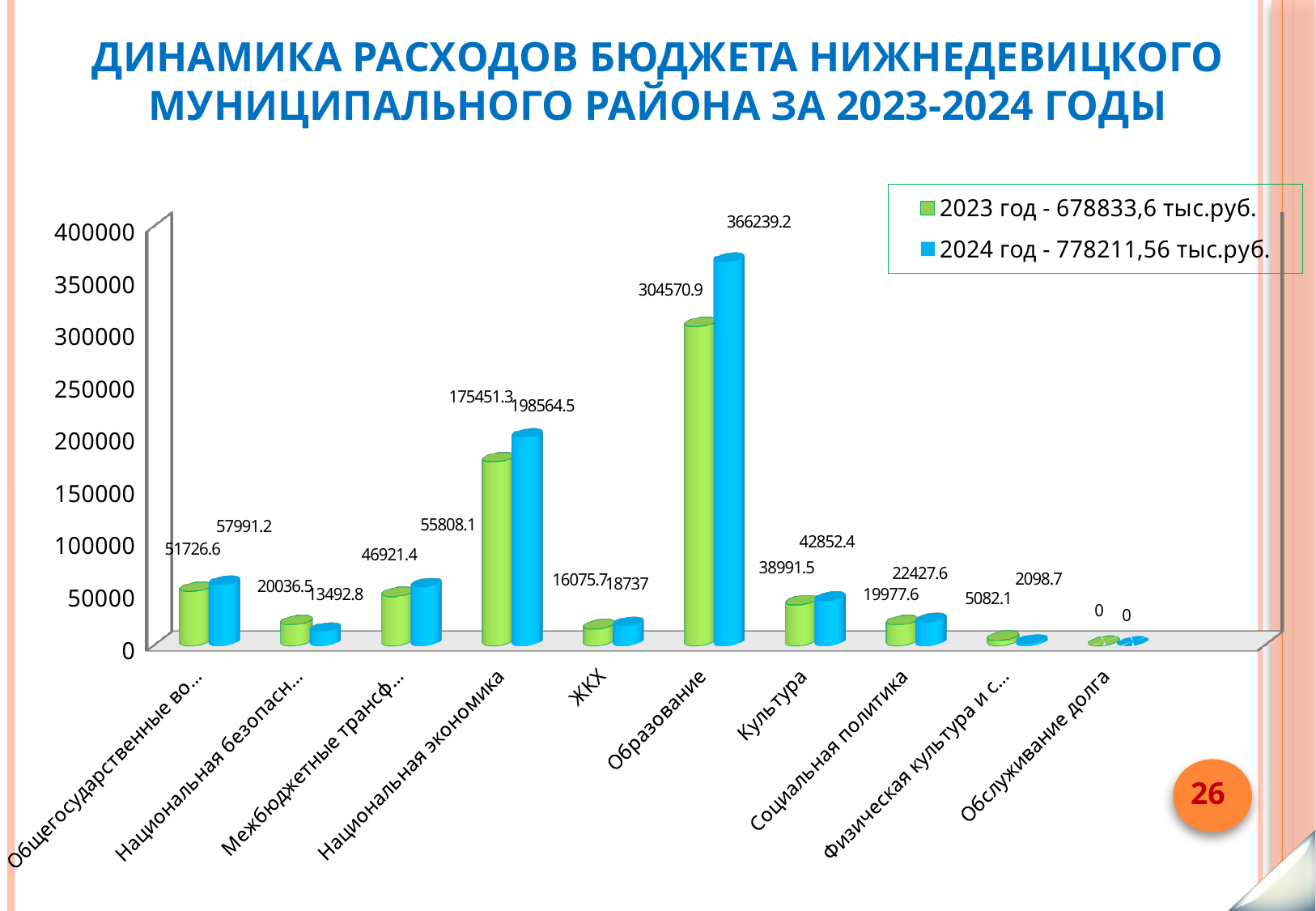
What is the 2023 value for Национальная экономика? 175451.3 What is the 2024 value for ЖКХ? 18737 What is the difference between the 2024 and 2023 values for Образование? 61668.3 Which category has the lowest 2023 value? Обслуживание долга What is the 2024 value for Образование? 366239.2 What kind of chart is shown on the slide? bar chart How many categories are shown on the x axis? 10 Is the 2024 value for Национальная экономика greater or less than 150000? greater Which category has the highest 2024 value? Образование What is the difference between the 2024 and 2023 values for Культура? 3860.9 For ЖКХ, which year has the larger value, 2023 or 2024? 2024 How many series does the legend list? 2